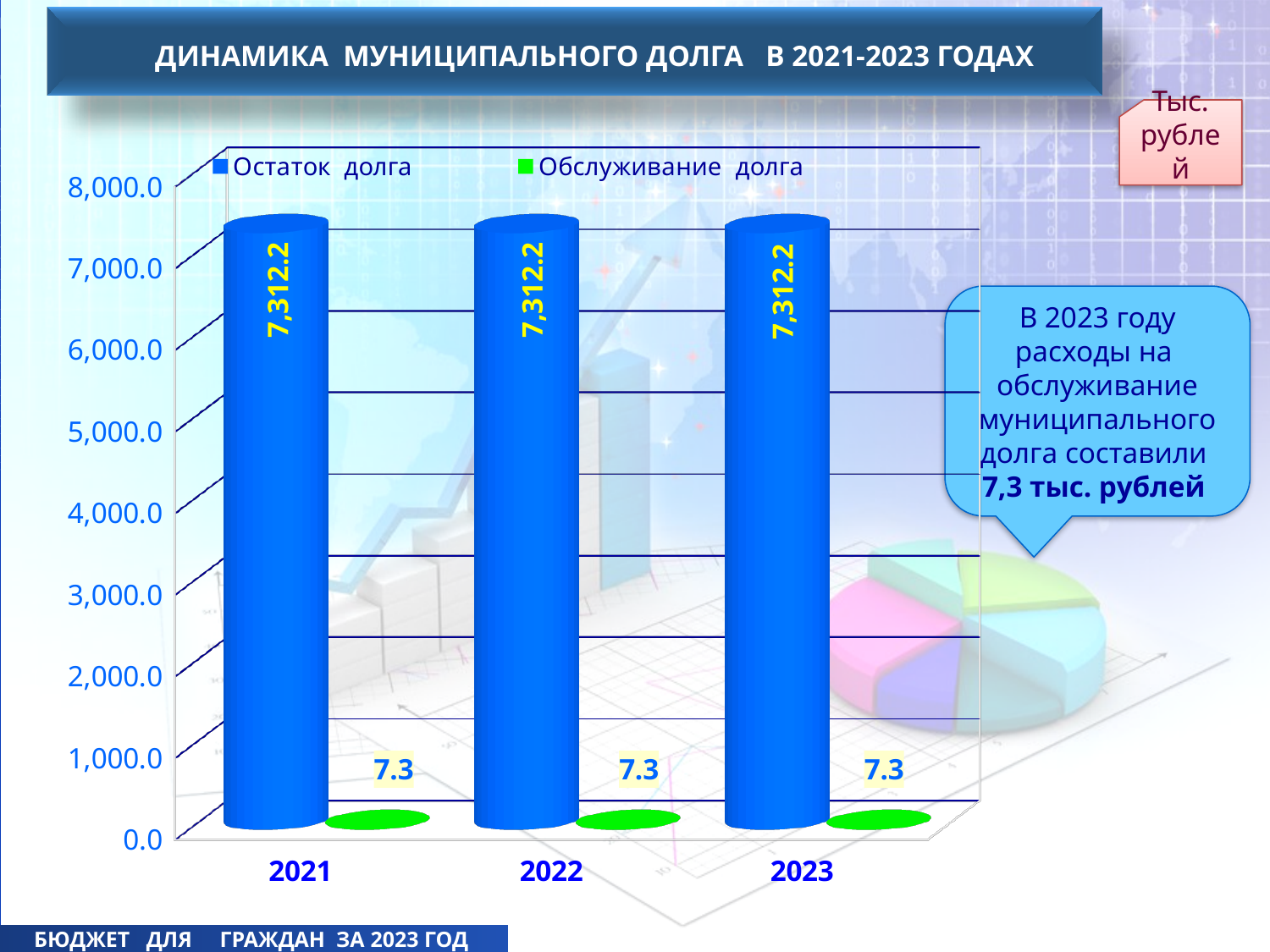
Which is larger in 2022, Остаток долга or Обслуживание долга? Остаток долга What is the difference between Остаток долга and Обслуживание долга in 2023? 7,304.9 What is the value of Остаток долга for 2023? 7,312.2 What is the value of Обслуживание долга for 2022? 7.3 Is the value of Обслуживание долга for 2021 greater or less than 1,000.0? less How many series does the chart legend list? 2 Is the value of Остаток долга for 2021 greater or less than 7,000.0? greater What is the value of Остаток долга for 2021? 7,312.2 What is the value of Обслуживание долга for 2023? 7.3 What kind of chart is shown on the slide? bar chart Does the value of Остаток долга rise, fall, or stay the same from 2021 to 2023? stays the same How many years are shown on the x axis of the chart? 3